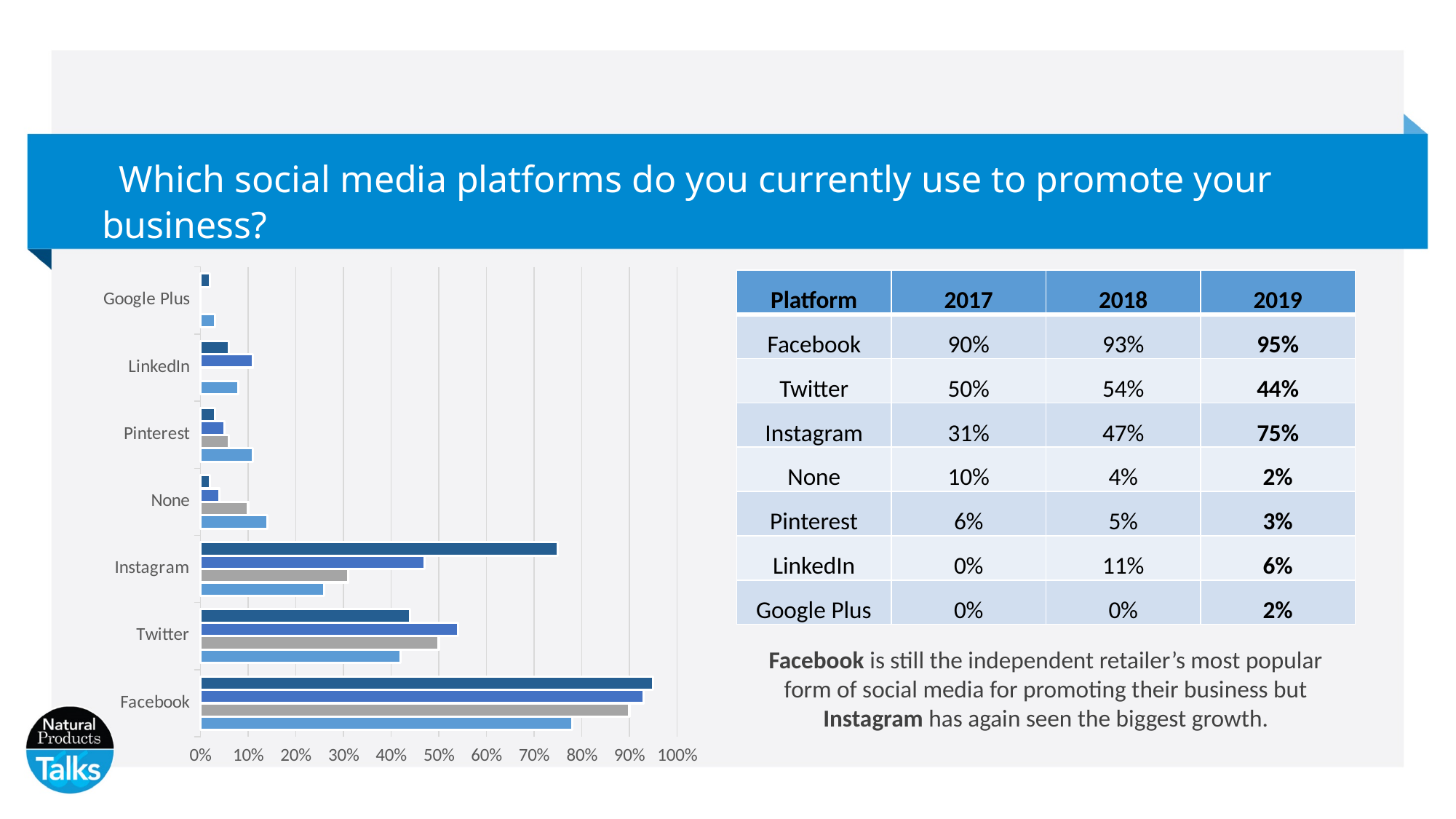
Is the longest bar for Facebook greater or less than 90%? greater What is the highest value shown on the horizontal axis of the chart? 100% Is the longest bar for None greater or less than 20%? less Which category has the longest bars in the chart? Facebook Which category appears at the top of the chart's vertical axis? Google Plus Is the longest bar for Instagram greater or less than 70%? greater How many bars are plotted for each category in the chart? 4 How many categories are listed on the vertical axis of the chart? 7 Which has the longer longest bar in the chart, Instagram or Twitter? Instagram What kind of chart is shown on the slide? bar chart Which category has the shortest bars in the chart? Google Plus